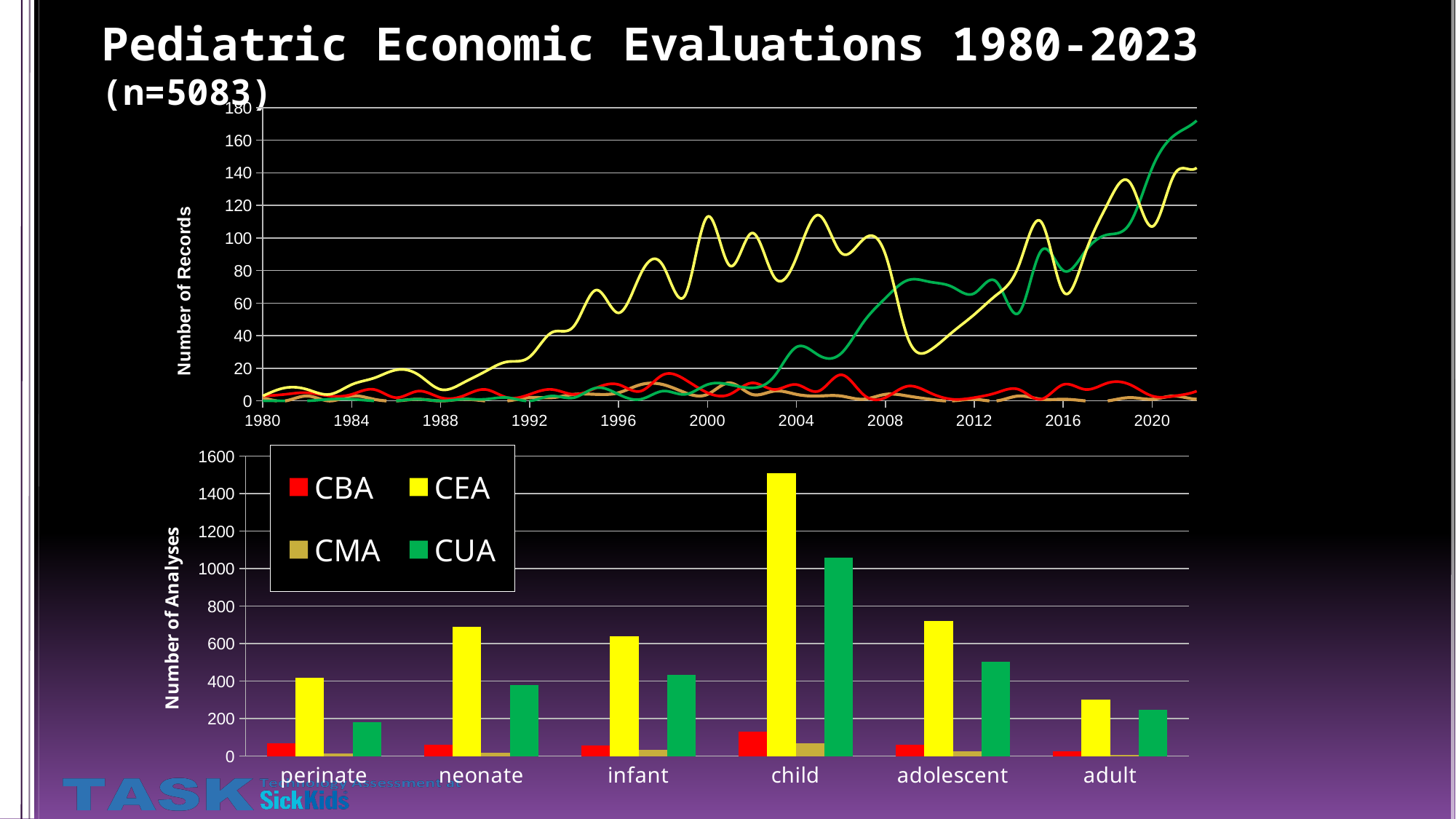
In the bottom bar chart, is the CEA value for adult greater or less than 400? less In the bottom bar chart, which age group has the highest CEA bar? child In the bottom bar chart, which age group has the lowest CUA bar? perinate In the bottom bar chart, which is larger for the adolescent group, the CEA bar or the CUA bar? CEA What kind of chart is the bottom chart on the slide? bar chart In the bottom bar chart, is the CEA value for child greater or less than 1400? greater In the bottom bar chart, is the CUA value for child greater or less than 1000? greater How many series does the legend list? 4 What kind of chart is the top chart on the slide? line chart In the top line chart, does the CUA line generally rise or fall between 2004 and 2020? rise In the bottom bar chart, how many age-group categories are shown on the x axis? 6